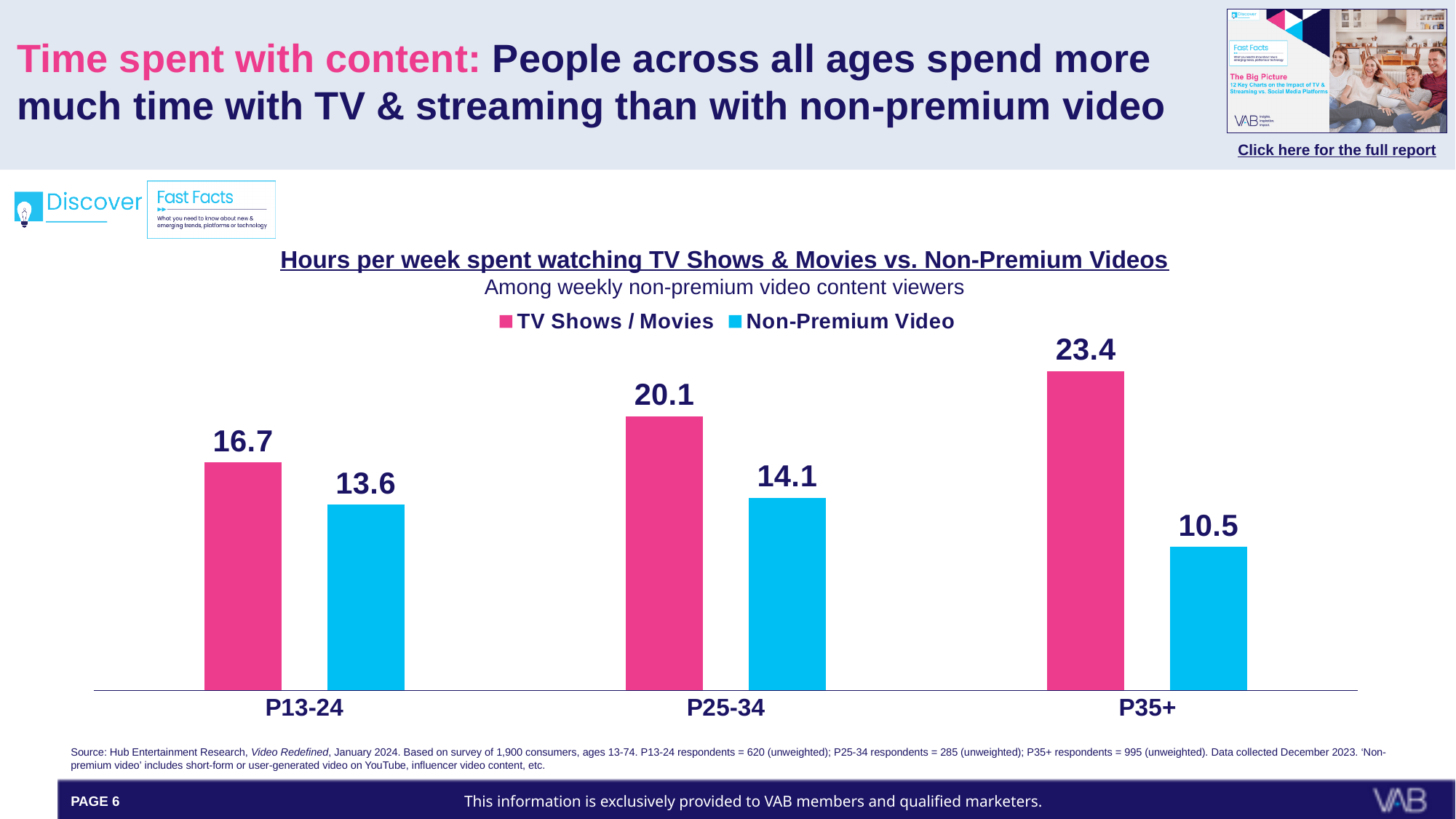
What is the value for Non-Premium Video for P35+? 10.5 How many series does the legend list? 2 Which age group has the highest value for TV Shows / Movies? P35+ What is the value for TV Shows / Movies for P13-24? 16.7 What is the value for Non-Premium Video for P25-34? 14.1 What is the difference between TV Shows / Movies and Non-Premium Video for P13-24? 3.1 Do the TV Shows / Movies values rise or fall from P13-24 to P35+? Rise Which is larger for P25-34: TV Shows / Movies or Non-Premium Video? TV Shows / Movies What is the difference between TV Shows / Movies and Non-Premium Video for P35+? 12.9 Which age group has the lowest value for Non-Premium Video? P35+ What kind of chart is shown on the slide? Bar chart How many age groups are shown on the x axis? 3